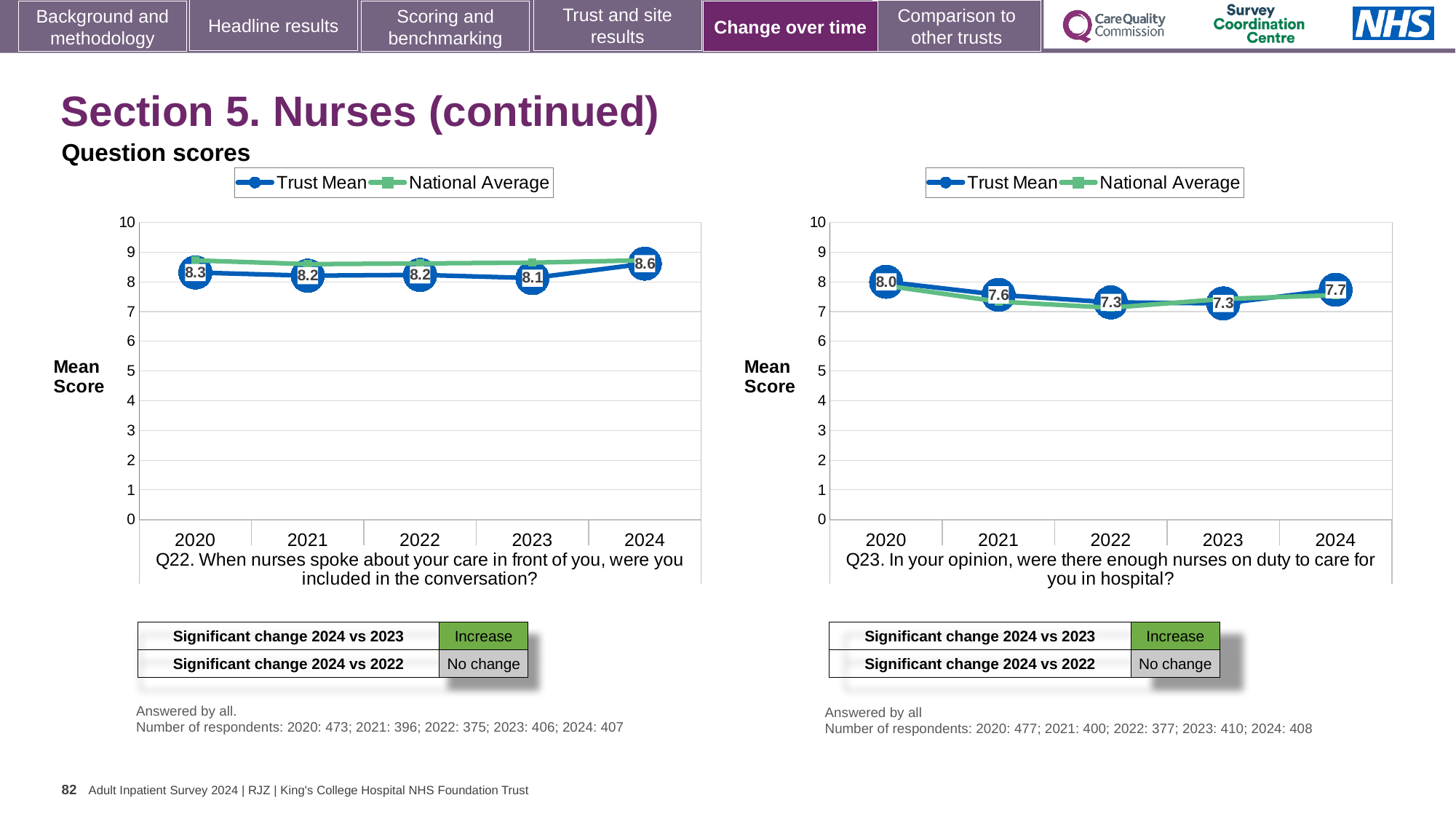
In the Q23 chart on the right, is the Trust Mean score for 2024 greater or less than 8? less In the Q22 chart on the left, what is the Trust Mean score for 2024? 8.6 In the Q22 chart on the left, what is the Trust Mean score for 2023? 8.1 In the Q23 chart on the right, what is the Trust Mean score for 2021? 7.6 What kind of chart is the Q23 chart on the right? Line chart In the Q23 chart on the right, which year has the highest Trust Mean score? 2020 How many series does the legend of the Q22 chart on the left list? 2 In the Q23 chart on the right, what is the Trust Mean score for 2020? 8.0 In the Q22 chart on the left, which year has the highest Trust Mean score? 2024 In the Q22 chart on the left, which year has the lowest Trust Mean score? 2023 In the Q22 chart on the left, what is the difference between the Trust Mean scores for 2024 and 2023? 0.5 In the Q23 chart on the right, what is the difference between the Trust Mean scores for 2020 and 2022? 0.7